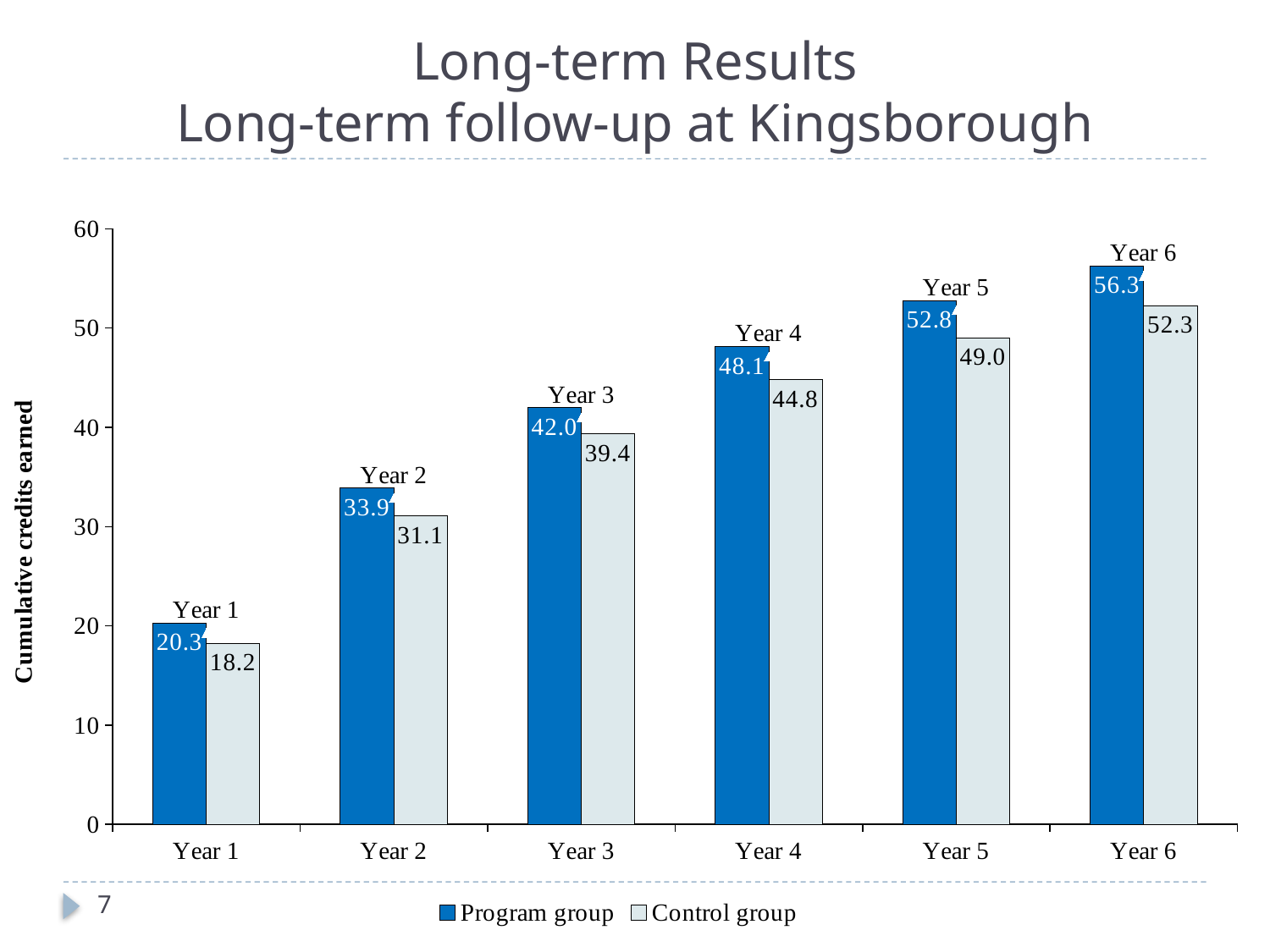
How many years are shown on the x axis? 6 What is the value for the Control group in Year 5? 49.0 What is the value for the Program group in Year 3? 42.0 What kind of chart is shown on the slide? Bar chart In which year is the Control group value lowest? Year 1 Do the Program group values rise or fall from Year 1 to Year 6? Rise In which year is the Program group value highest? Year 6 Which is larger in Year 2: the Program group value or the Control group value? Program group Is the value for the Control group in Year 6 greater or less than 50? greater What is the value for the Control group in Year 1? 18.2 How many series does the legend list? 2 What is the difference between the Program group and Control group values in Year 4? 3.3